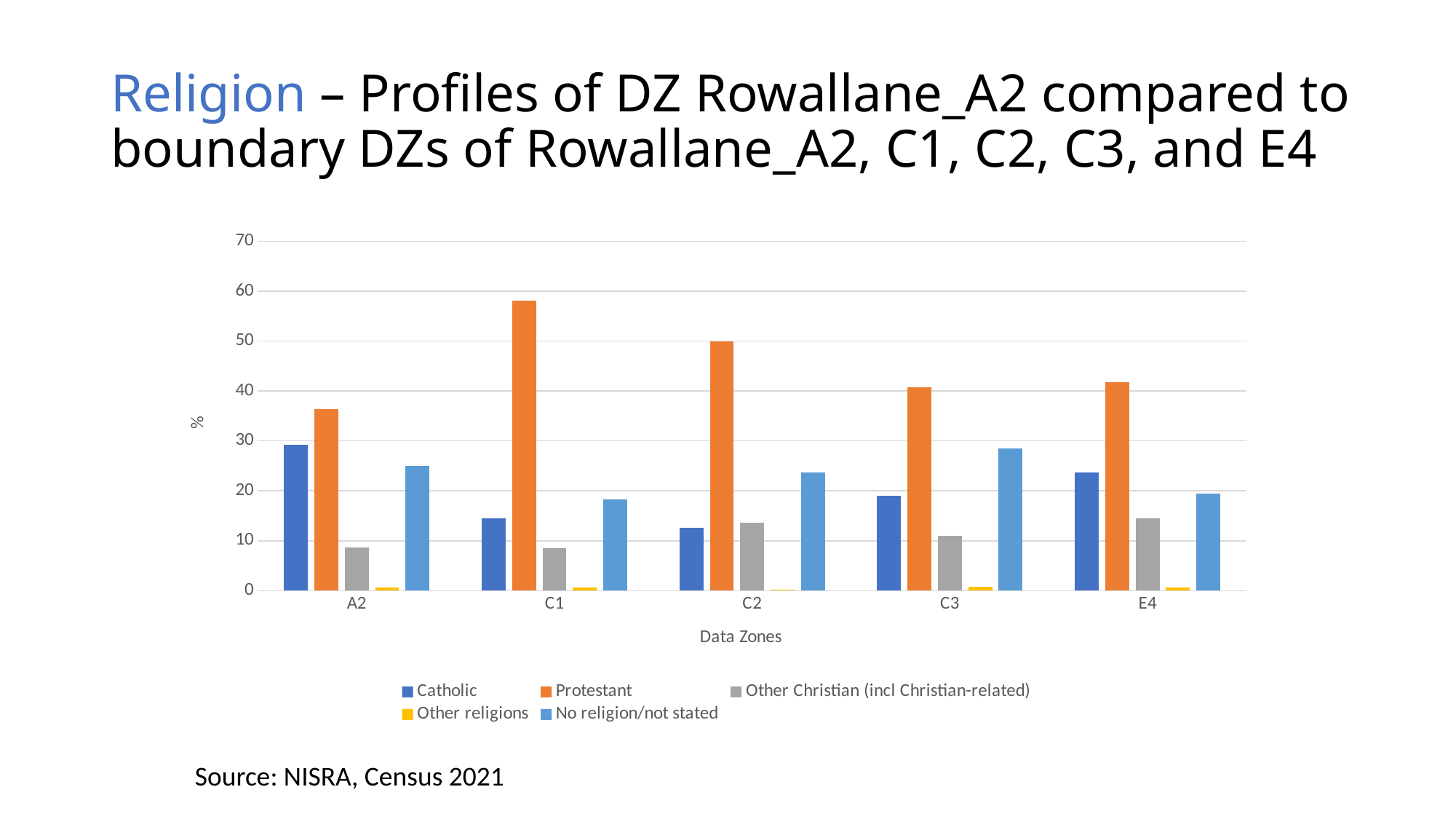
Which is larger: the No religion/not stated value for C3 or for C1? C3 How many series does the legend list? 5 What is the title of the x axis? Data Zones Which data zone has the lowest Catholic value? C2 Which data zone has the highest No religion/not stated value? C3 Which data zone has the highest Catholic value? A2 Is the Protestant value for A2 greater or less than 40? less Is the Protestant value for C1 greater or less than 50? greater Is the Catholic value for A2 greater or less than 20? greater Which data zone has the highest Protestant value? C1 What kind of chart is shown on the slide? Bar chart How many data zones are shown on the x axis? 5